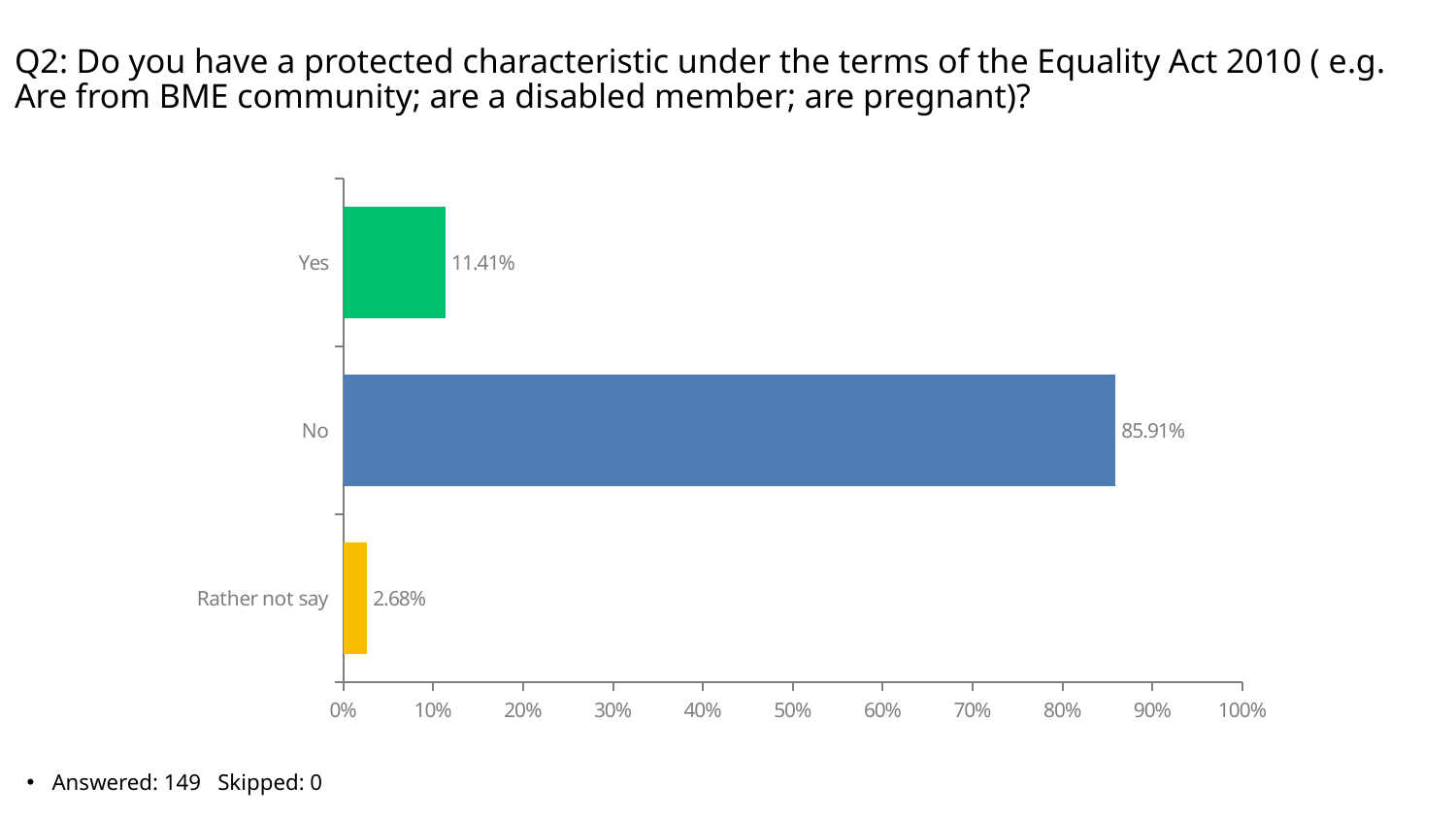
What percentage of respondents answered "Yes"? 11.41% What is the difference in percentage points between "No" and "Yes"? 74.5 Is the value for "No" greater or less than 80%? greater How many response categories are shown in the chart? 3 What colour is the bar for "No"? Blue Which response has the highest percentage? No What type of chart is shown on the slide? Bar chart What is the difference in percentage points between "Yes" and "Rather not say"? 8.73 Which response has the lowest percentage? Rather not say What percentage of respondents answered "Rather not say"? 2.68% Which is larger, the percentage for "Yes" or for "Rather not say"? Yes What percentage of respondents answered "No"? 85.91%